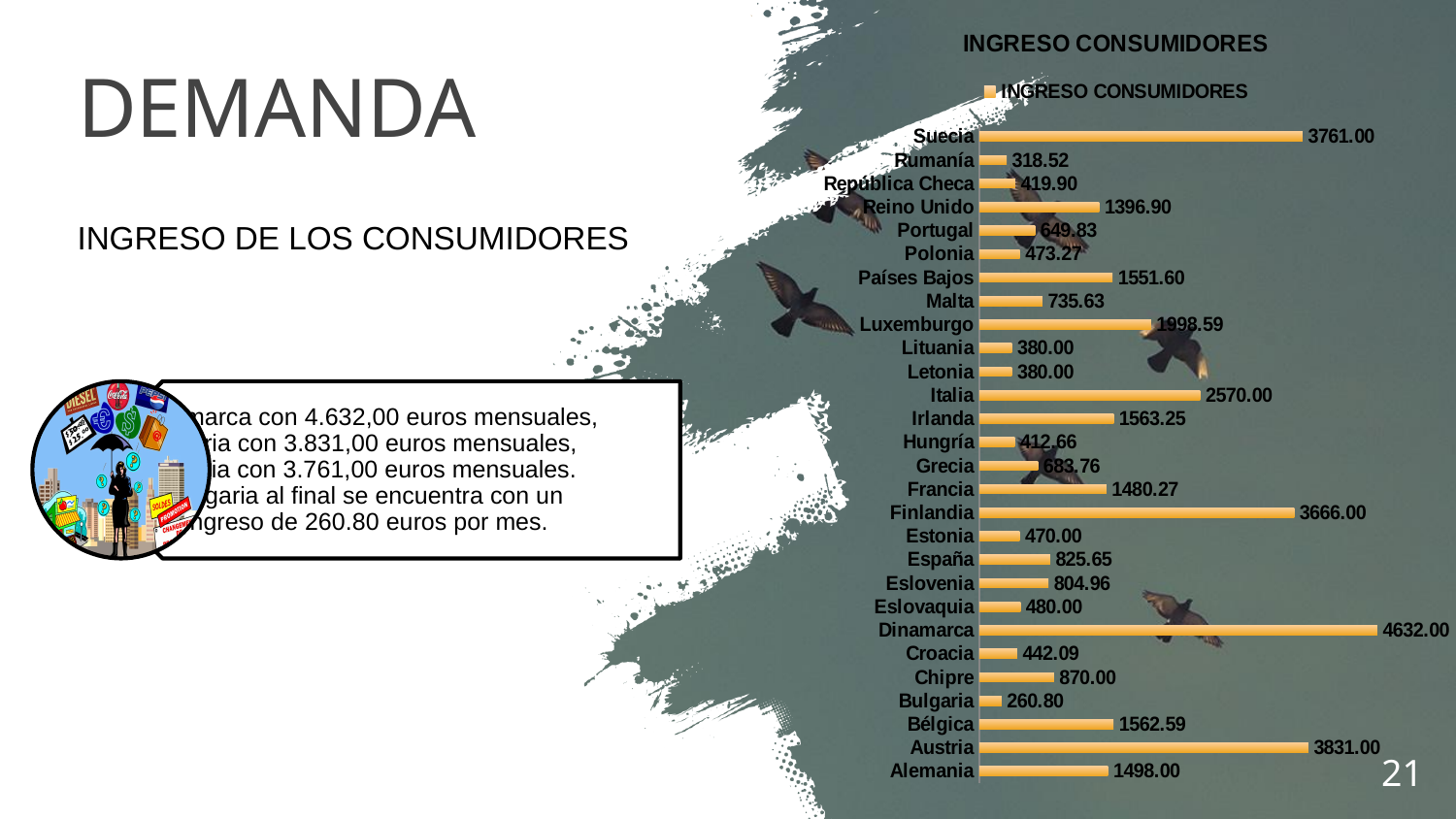
What is the value for Luxemburgo in the INGRESO CONSUMIDORES chart? 1998.59 Which country has the lowest value in the INGRESO CONSUMIDORES chart? Bulgaria What type of chart is shown on the slide? Bar chart What is the value for Bulgaria in the INGRESO CONSUMIDORES chart? 260.80 How many series does the legend of the INGRESO CONSUMIDORES chart list? 1 Which has a larger value in the INGRESO CONSUMIDORES chart, Italia or Luxemburgo? Italia What is the difference between the values for Suecia and Finlandia in the INGRESO CONSUMIDORES chart? 95.00 What is the title of the chart on the slide? INGRESO CONSUMIDORES Which country has the highest value in the INGRESO CONSUMIDORES chart? Dinamarca How many countries are shown in the INGRESO CONSUMIDORES chart? 28 What is the value for Suecia in the INGRESO CONSUMIDORES chart? 3761.00 What is the difference between the values for Dinamarca and Austria in the INGRESO CONSUMIDORES chart? 801.00